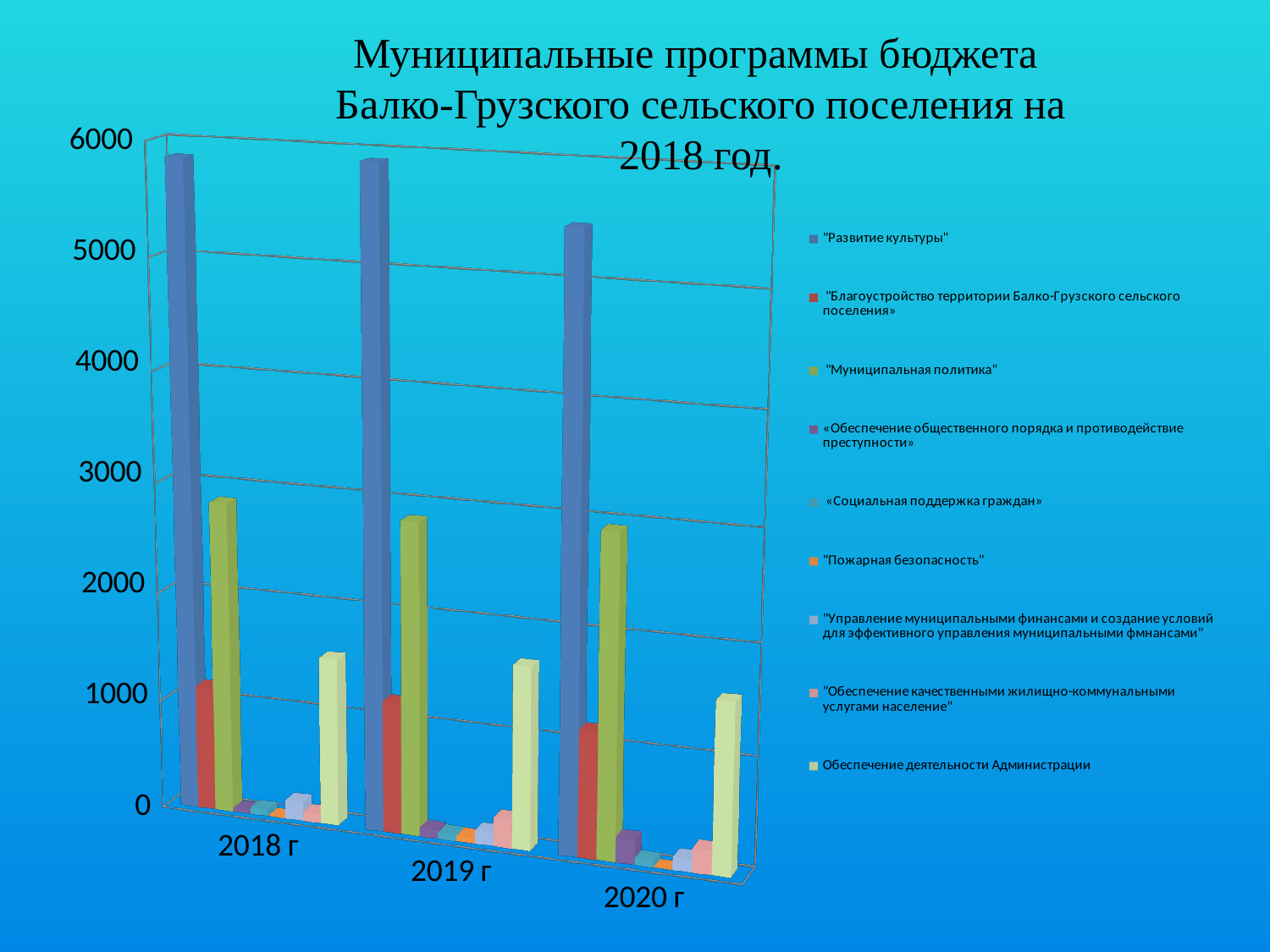
How many series does the chart's legend list? 9 What is the title of the chart on the slide? Муниципальные программы бюджета Балко-Грузского сельского поселения на 2018 год. In 2019 г, which is larger: "Развитие культуры" or "Муниципальная политика"? "Развитие культуры" What kind of chart is shown on the slide? Bar chart Which series has the highest value in the 2018 г category? "Развитие культуры" Is the value for "Развитие культуры" in 2020 г greater or less than 4000? greater Do the values for "Развитие культуры" rise or fall from 2018 г to 2020 г? fall How many categories (years) are shown on the x axis of the chart? 3 In 2020 г, which is larger: "Муниципальная политика" or "Обеспечение деятельности Администрации"? "Муниципальная политика" Is the value for "Муниципальная политика" in 2018 г greater or less than 3000? less Is the value for "Обеспечение деятельности Администрации" in 2018 г greater or less than 2000? less